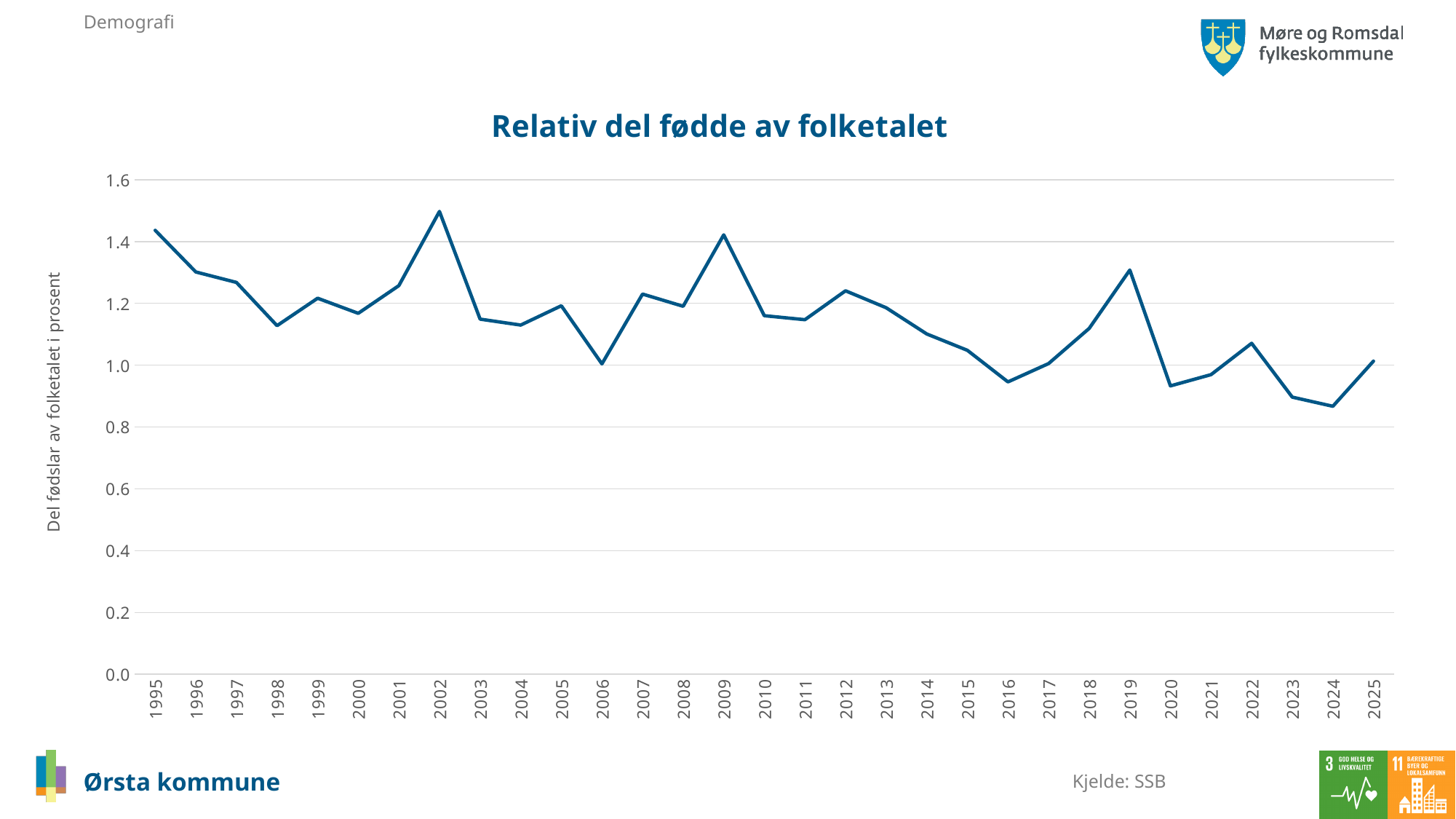
How many years are plotted along the x axis of the chart? 31 Is the value for 2016 greater or less than 1.0? less Which year has the larger value, 1995 or 2025? 1995 What is the label on the vertical axis of the chart? Del fødslar av folketalet i prosent Which year has the larger value, 2002 or 2009? 2002 Is the value for 2002 greater or less than 1.4? greater Is the value for 2019 greater or less than 1.2? greater What kind of chart is shown on the slide? line chart What is the title of the chart? Relativ del fødde av folketalet In which year does the line reach its highest value? 2002 Overall, does the line rise or fall from 1995 to 2025? fall